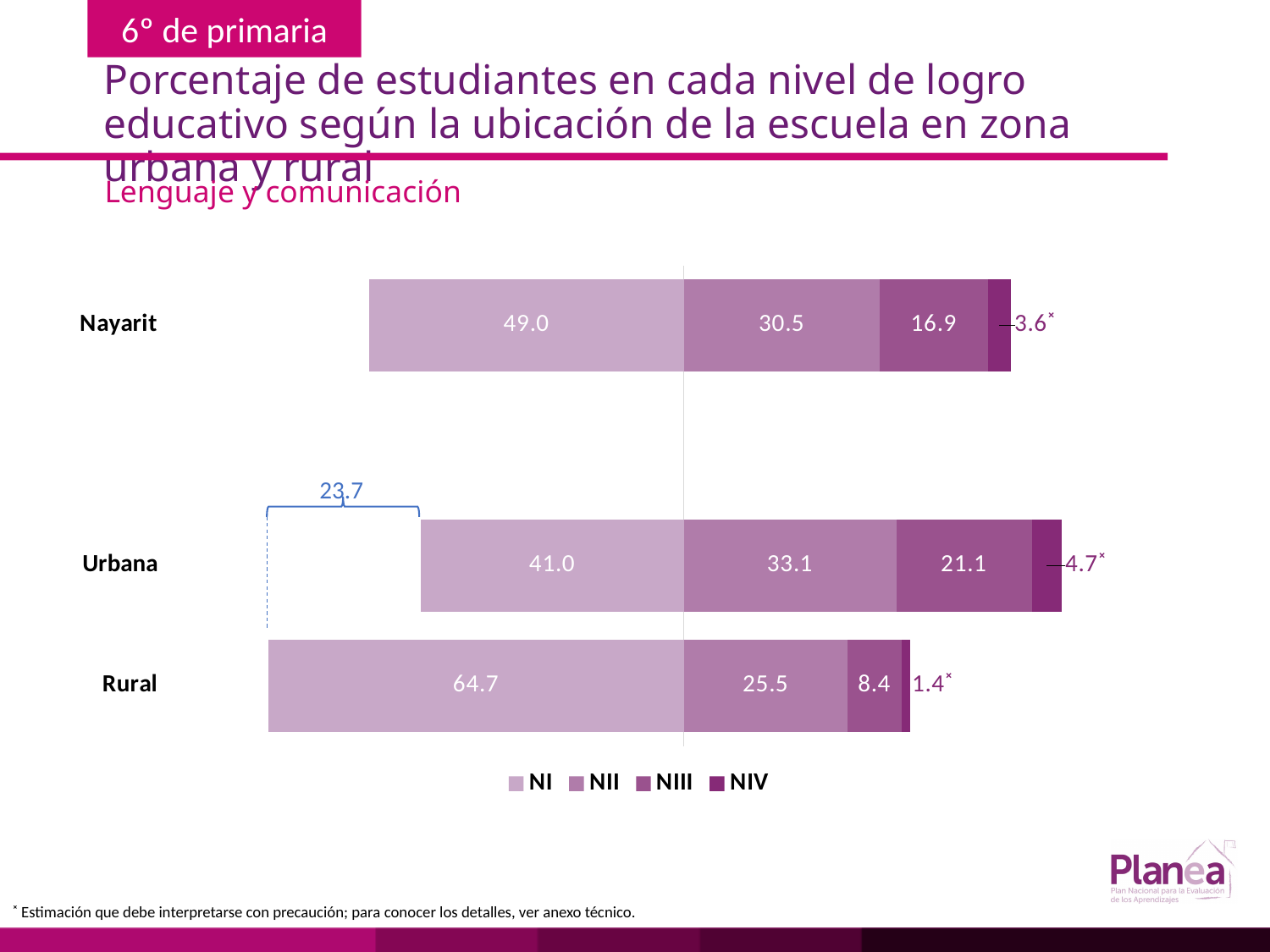
Which category has the highest NI value? Rural What is the NI value for Rural? 64.7 What is the NII value for Urbana? 33.1 How many categories (bars) are shown in the chart? 3 What is the NIV value for Rural? 1.4 Which category has the lowest NIII value? Rural Which is larger, the NII value for Nayarit or the NII value for Rural? Nayarit What type of chart is shown on the slide? stacked bar chart What is the total of the stacked bar for Nayarit? 100.0 How many series does the legend list? 4 What is the difference between the NI values for Rural and Urbana? 23.7 What is the NIII value for Nayarit? 16.9